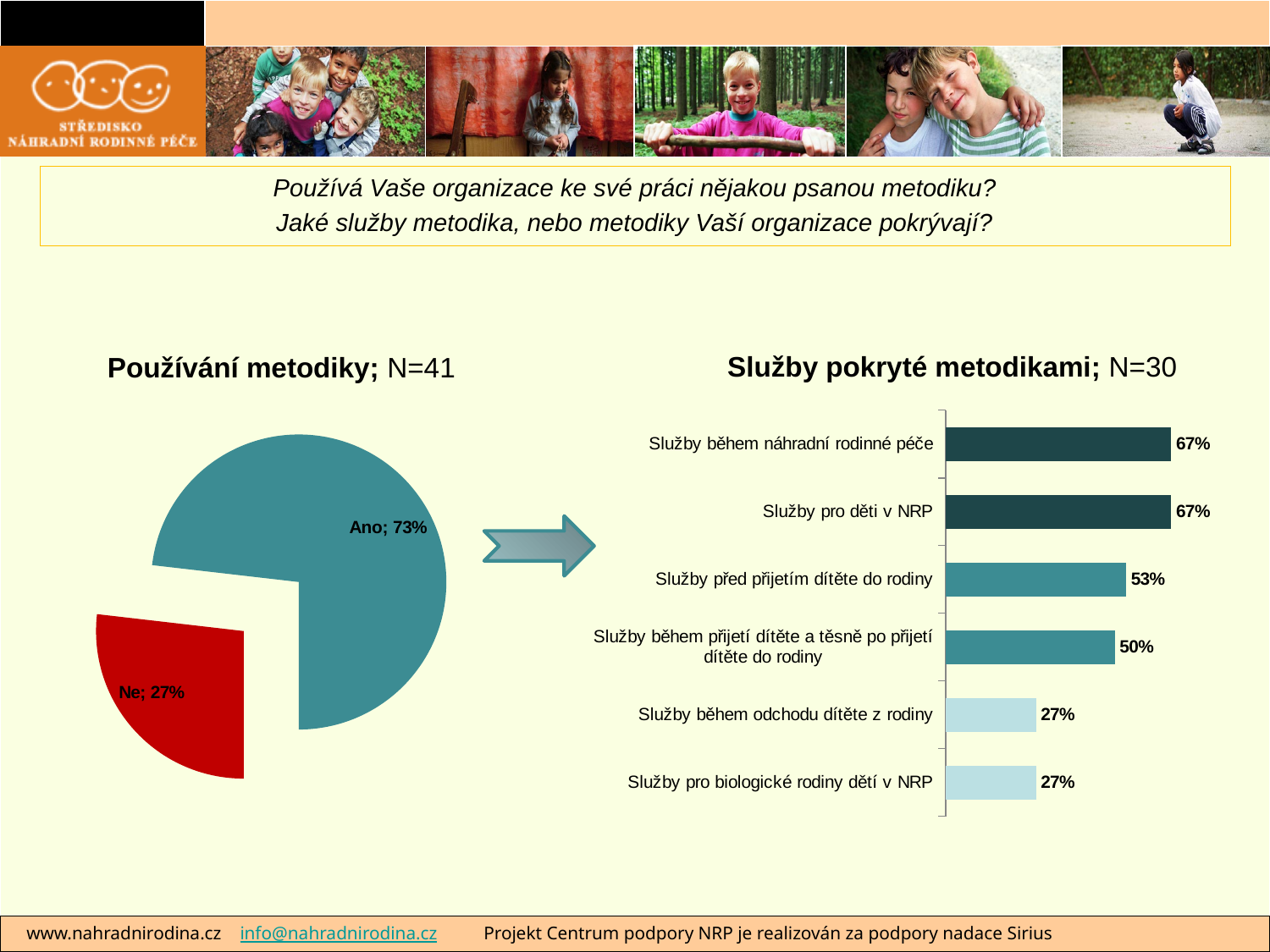
In the 'Služby pokryté metodikami' chart, what is the value for 'Služby před přijetím dítěte do rodiny'? 53% How many categories are shown in the 'Služby pokryté metodikami' bar chart? 6 In the 'Služby pokryté metodikami' chart, what is the value for 'Služby během přijetí dítěte a těsně po přijetí dítěte do rodiny'? 50% In the 'Používání metodiky' pie chart, what is the difference between the 'Ano' and 'Ne' shares? 46% In the 'Používání metodiky' pie chart, what share is labelled 'Ano'? 73% In the 'Služby pokryté metodikami' chart, which is larger: 'Služby pro děti v NRP' or 'Služby během odchodu dítěte z rodiny'? Služby pro děti v NRP In the 'Služby pokryté metodikami' chart, what is the difference between 'Služby během náhradní rodinné péče' and 'Služby před přijetím dítěte do rodiny'? 14% In the 'Používání metodiky' pie chart, what share is labelled 'Ne'? 27% What kind of chart is the 'Používání metodiky' chart on the left? pie chart What kind of chart is the 'Služby pokryté metodikami' chart on the right? bar chart How many slices does the 'Používání metodiky' pie chart have? 2 In the 'Služby pokryté metodikami' chart, what is the value for 'Služby pro biologické rodiny dětí v NRP'? 27%